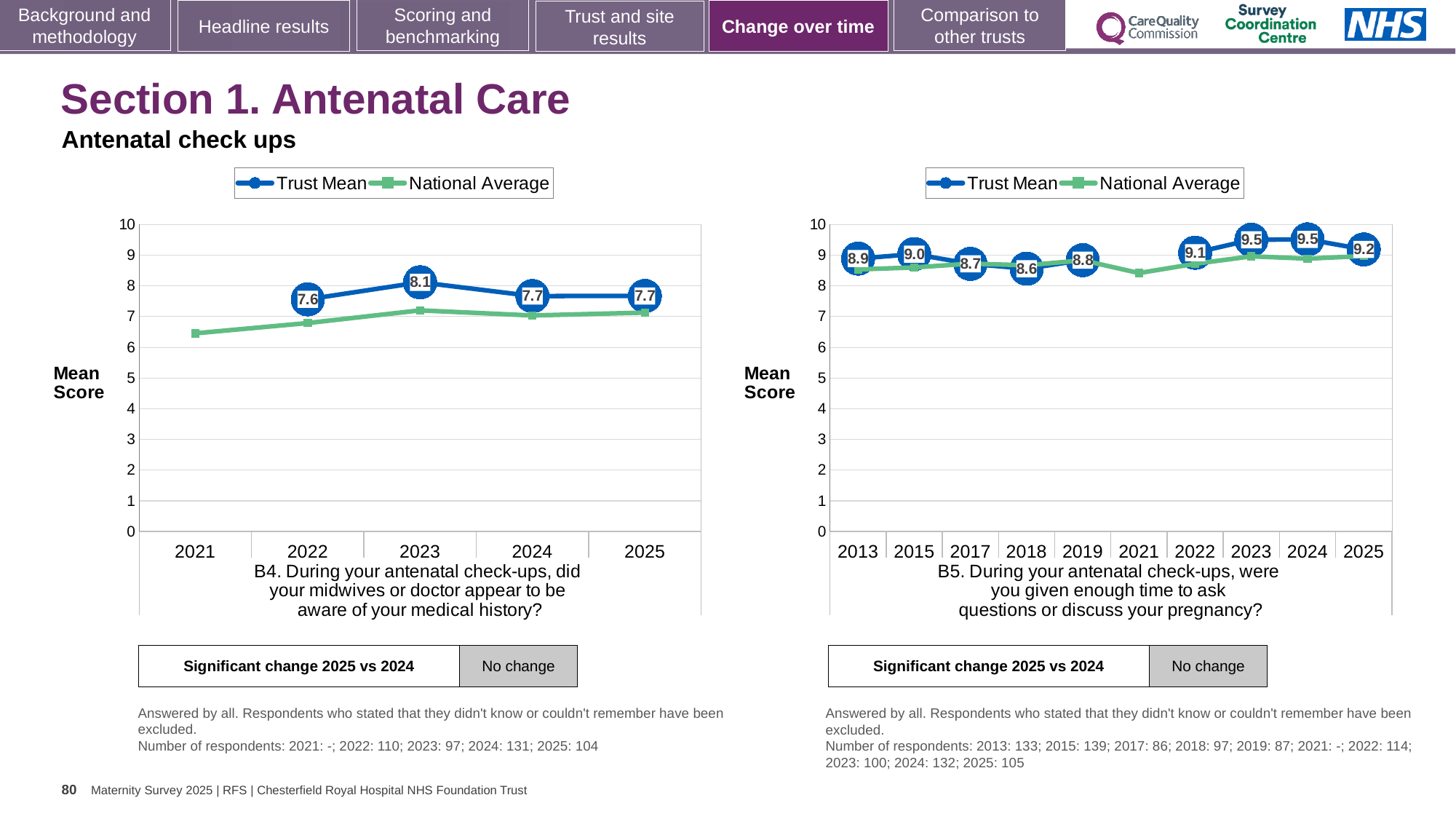
In the right chart (B5), is the Trust Mean higher in 2023 or in 2025? 2023 In the right chart (B5), how many years are shown on the x axis? 10 How many series does the legend of the left chart (B4) list? 2 In the right chart (B5), what is the Trust Mean for 2018? 8.6 In the left chart (B4), what is the Trust Mean for 2022? 7.6 In the right chart (B5), which year has the lowest Trust Mean? 2018 In the left chart (B4), what is the Trust Mean for 2023? 8.1 In the left chart (B4), is the National Average for 2021 greater or less than 7? less In the left chart (B4), which year has the highest Trust Mean? 2023 In the left chart (B4), what is the difference between the Trust Mean in 2023 and in 2024? 0.4 What type of chart is the right chart (B5)? Line chart In the right chart (B5), what is the Trust Mean for 2025? 9.2